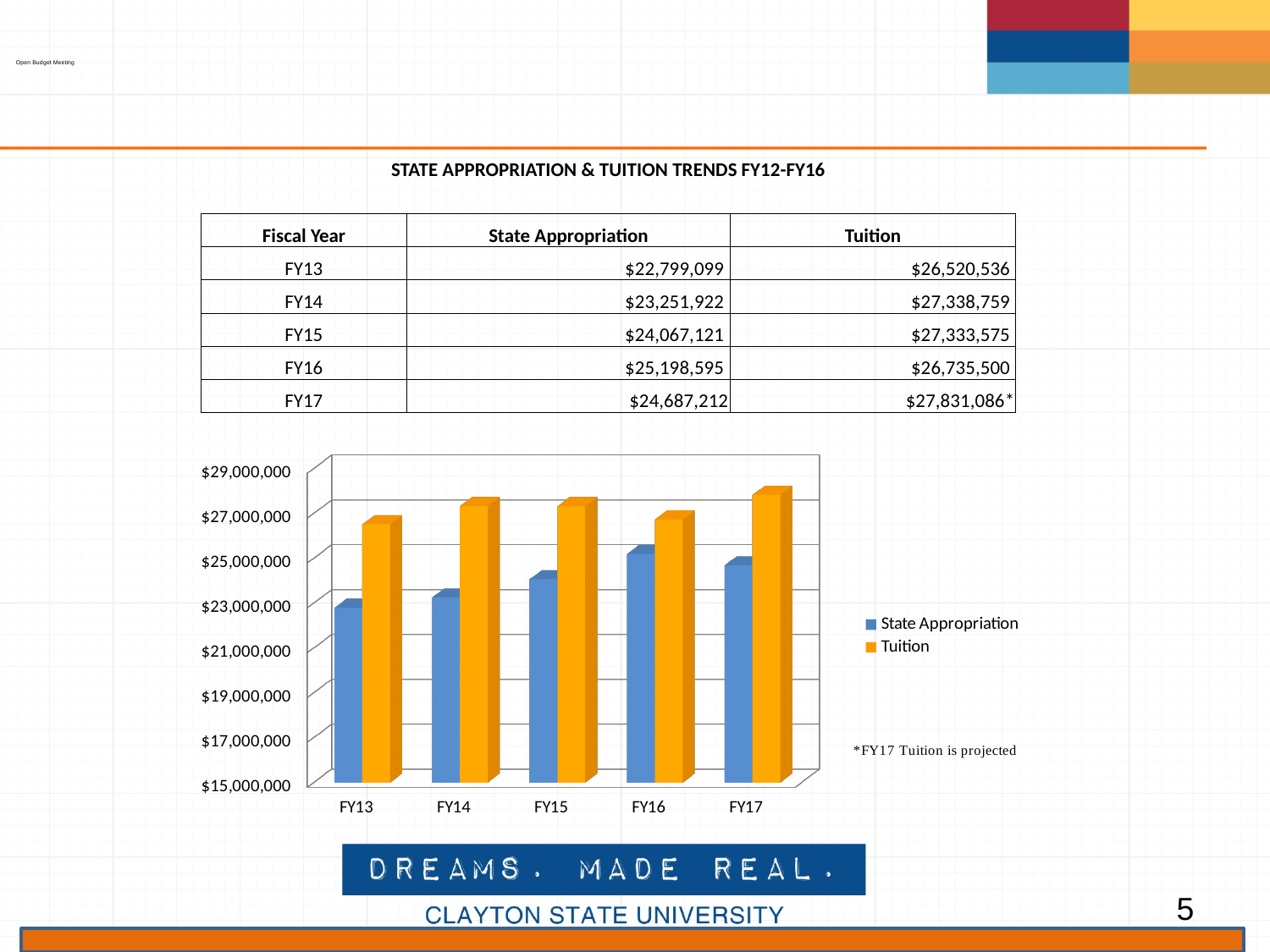
Which fiscal year has the lowest Tuition? FY13 Which is larger, the State Appropriation for FY15 or for FY16? FY16 What is the State Appropriation value for FY16? $25,198,595 Which fiscal year has the highest State Appropriation? FY16 What is the difference between Tuition and State Appropriation in FY13? $3,721,437 What colour represents Tuition in the chart? Orange What kind of chart is shown on the slide? Bar chart Is the State Appropriation bar for FY13 greater or less than $23,000,000? less How many series does the chart legend list? 2 What is the Tuition value for FY17? $27,831,086 Does the State Appropriation rise or fall from FY13 to FY16? rise How many fiscal years are plotted on the x axis of the chart? 5